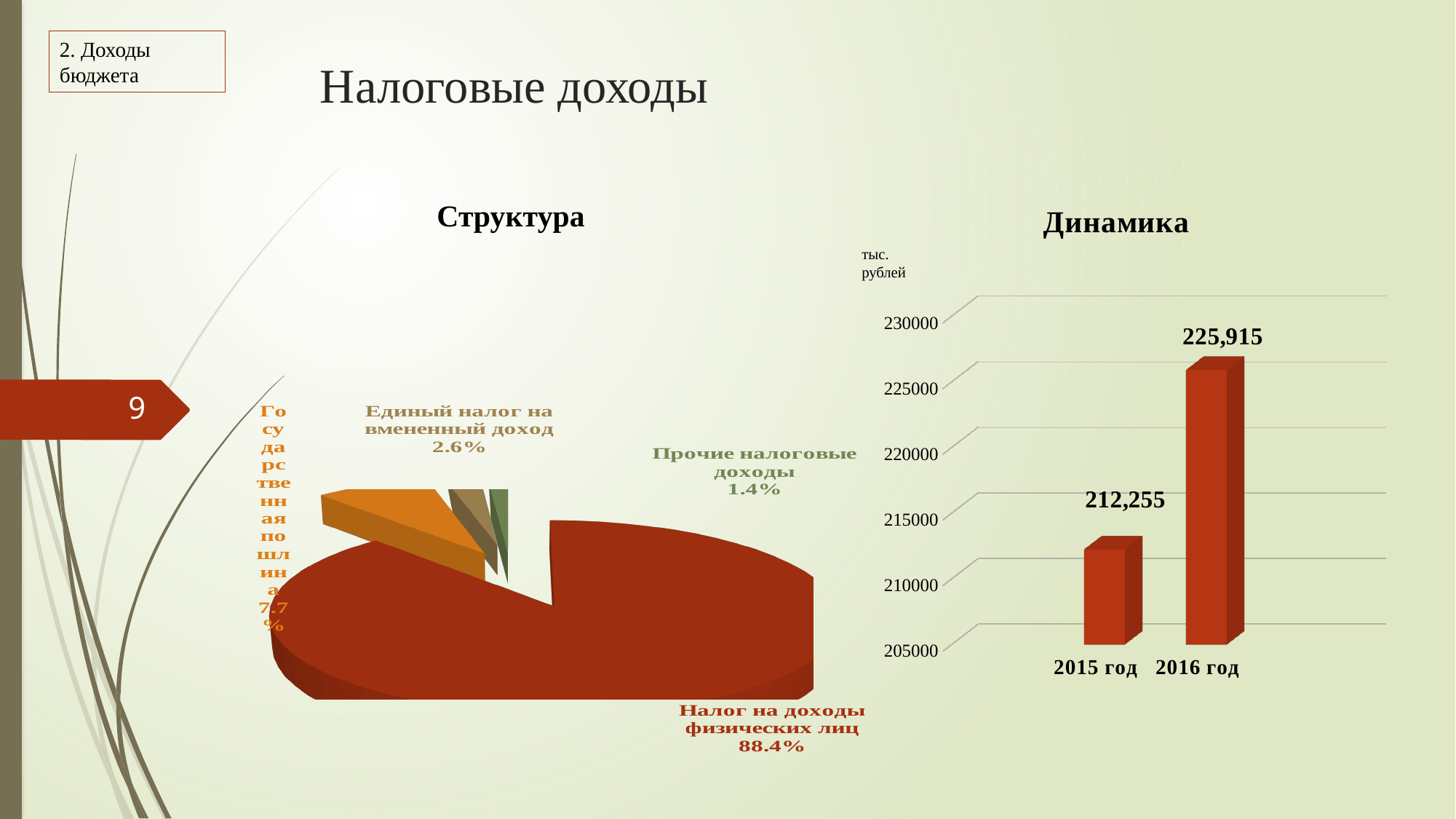
In the 'Структура' pie chart, what share does 'Прочие налоговые доходы' have? 1.4% In the 'Структура' pie chart, which slice is the largest? Налог на доходы физических лиц How many slices does the 'Структура' pie chart have? 4 In the 'Структура' pie chart, which slice is the smallest? Прочие налоговые доходы What kind of chart is the 'Структура' chart? Pie chart In the 'Динамика' chart, what is the value for 2015 год? 212,255 In the 'Динамика' chart, what is the value for 2016 год? 225,915 In the 'Динамика' chart, do the values rise or fall from 2015 год to 2016 год? Rise In the 'Структура' pie chart, what share does 'Налог на доходы физических лиц' have? 88.4% In the 'Динамика' chart, what is the difference between the 2016 год and 2015 год values? 13,660 In the 'Структура' pie chart, what share does 'Единый налог на вмененный доход' have? 2.6% What unit is shown on the axis of the 'Динамика' chart? тыс. рублей